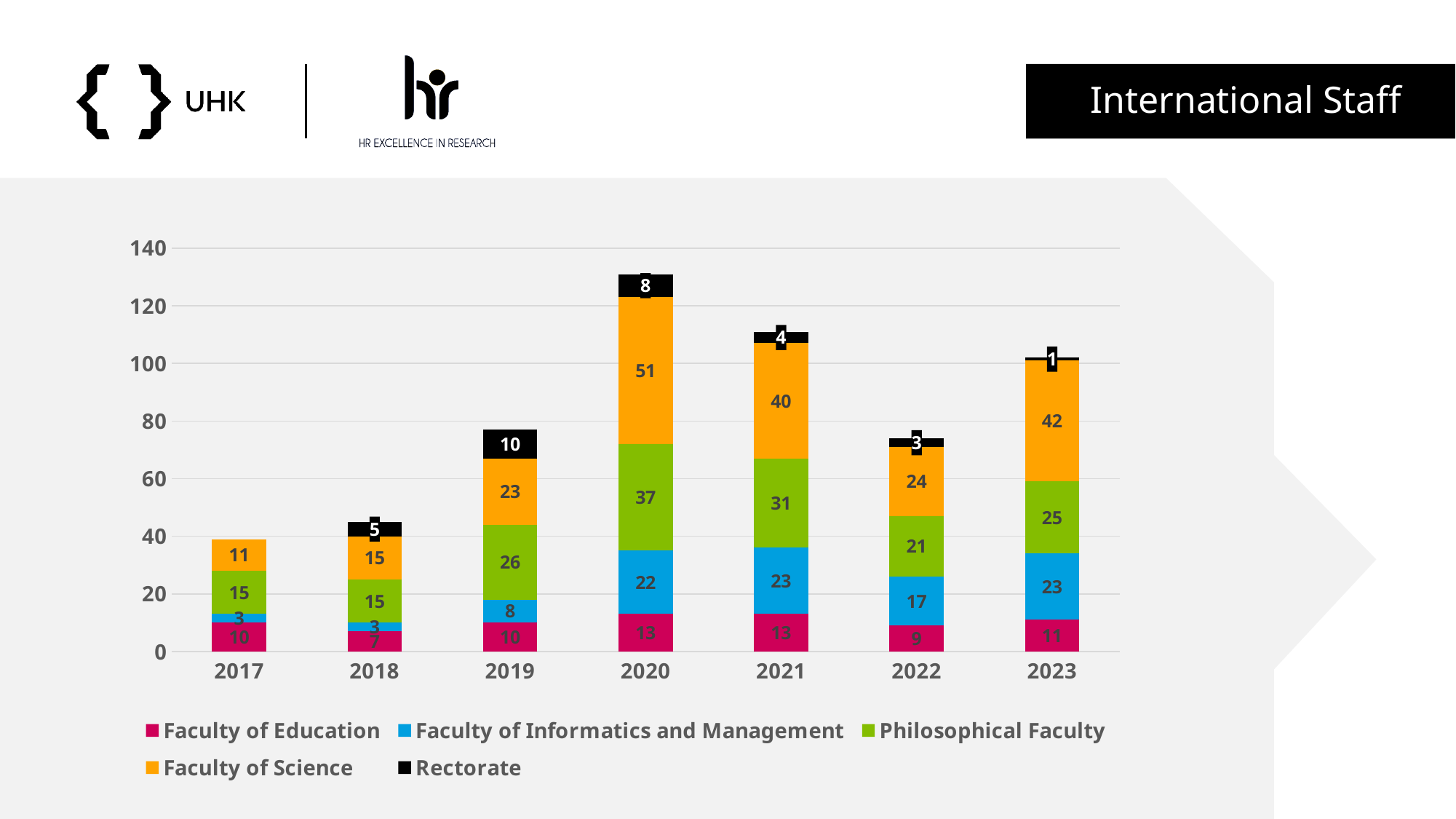
How many years are shown on the x axis? 7 Does the Faculty of Informatics and Management value rise or fall from 2017 to 2020? Rise In which year is the Faculty of Education value lowest? 2018 In which year is the Faculty of Science value highest? 2020 How many series does the legend list? 5 What is the value for Faculty of Science in 2020? 51 What is the value for Rectorate in 2019? 10 What is the value for Philosophical Faculty in 2019? 26 What is the difference between the Faculty of Informatics and Management values in 2020 and 2019? 14 What is the total of the stacked bar for 2020? 131 Which year has the larger Philosophical Faculty value, 2021 or 2023? 2021 What kind of chart is shown on the slide? Stacked bar chart